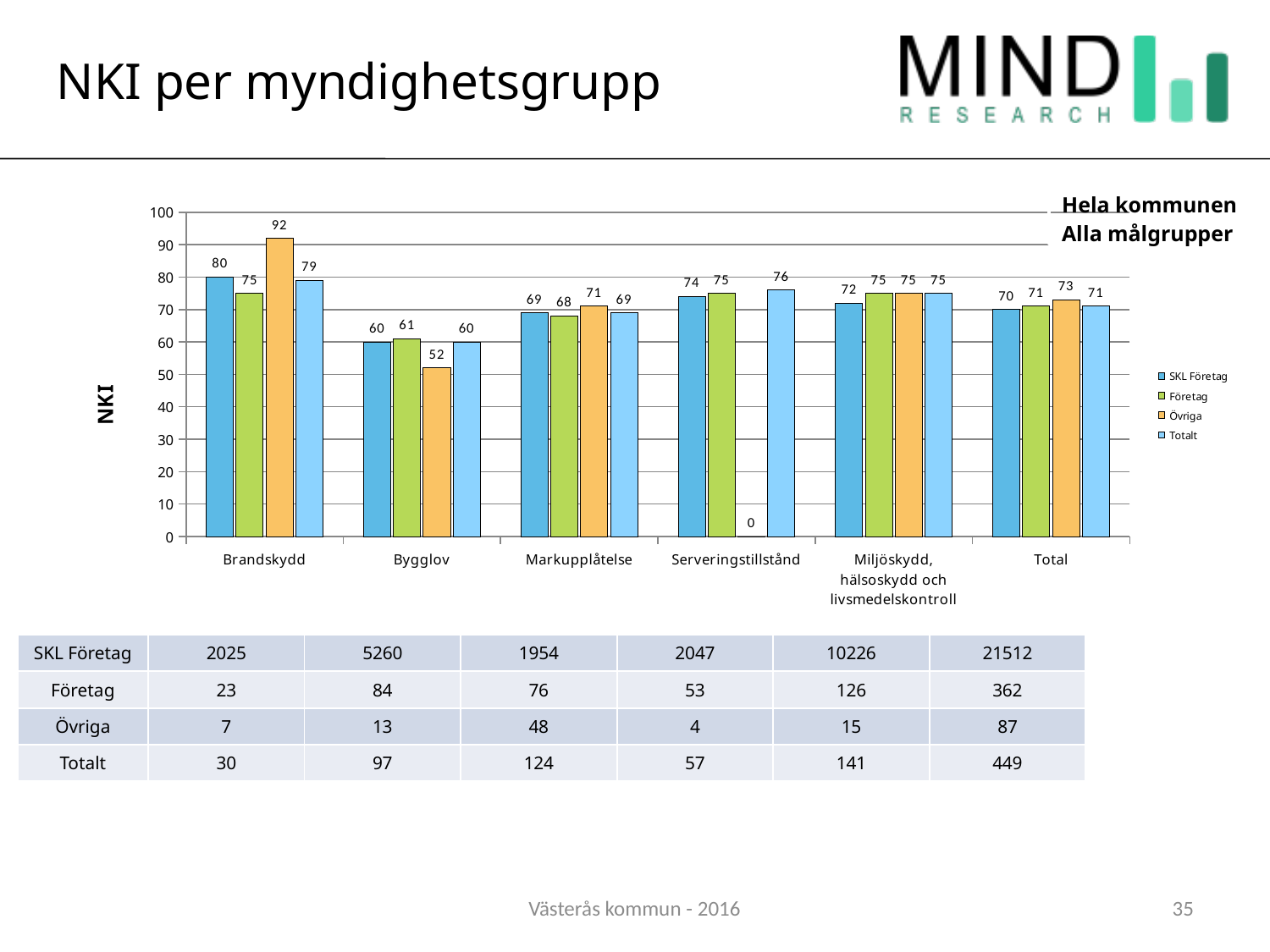
Which is larger in the Bygglov category, the Företag value or the Övriga value? Företag How many series does the chart legend list? 4 What is the difference between the Övriga value and the Företag value in the Brandskydd category? 17 What is the NKI value for Övriga in the Brandskydd category? 92 Which category has the highest Övriga value? Brandskydd Which category has the lowest SKL Företag value? Bygglov What is the NKI value for SKL Företag in the Bygglov category? 60 What is the NKI value for Övriga in the Serveringstillstånd category? 0 What kind of chart is shown on the slide? Bar chart How many categories are shown on the x axis of the chart? 6 What is the NKI value for Totalt in the Serveringstillstånd category? 76 What is the label on the vertical axis of the chart? NKI